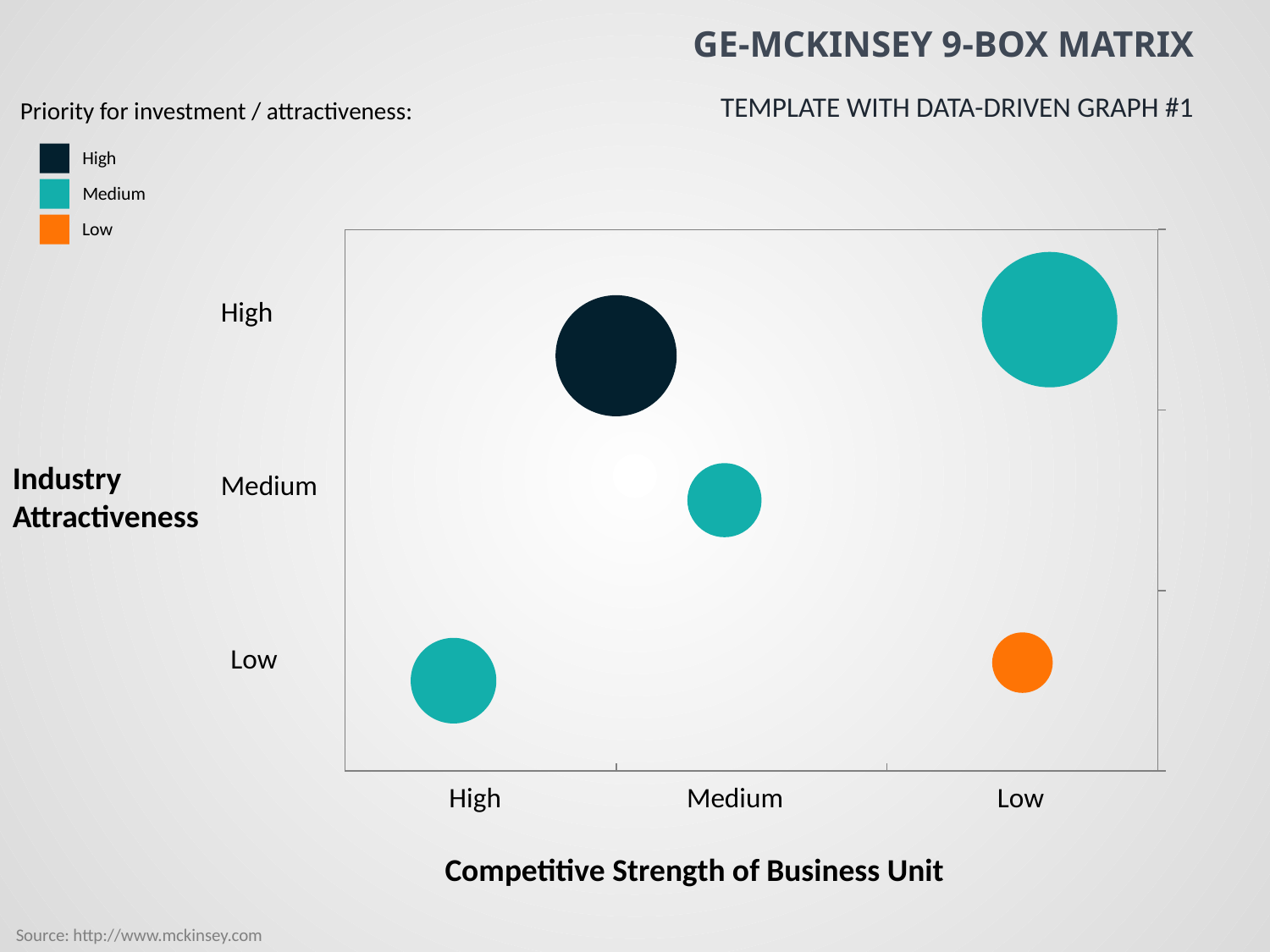
Which bubble is the smallest on the chart? The orange bubble at Low attractiveness and Low competitive strength Which priority level does the dark bubble at High industry attractiveness have? High Which priority level does the bubble at Low industry attractiveness and Low competitive strength have? Low What is the title of the vertical axis? Industry Attractiveness Is the teal bubble at High attractiveness and Low strength larger or smaller than the teal bubble at Medium attractiveness and Medium strength? Larger Which bubble is the largest on the chart? The teal bubble at High attractiveness and Low competitive strength How many categories are shown on the vertical axis? 3 What kind of chart is shown on the slide? Bubble chart What is the title of the horizontal axis? Competitive Strength of Business Unit How many categories are shown on the horizontal axis? 3 How many orange (Low priority) bubbles are plotted? 1 How many priority levels does the legend list? 3